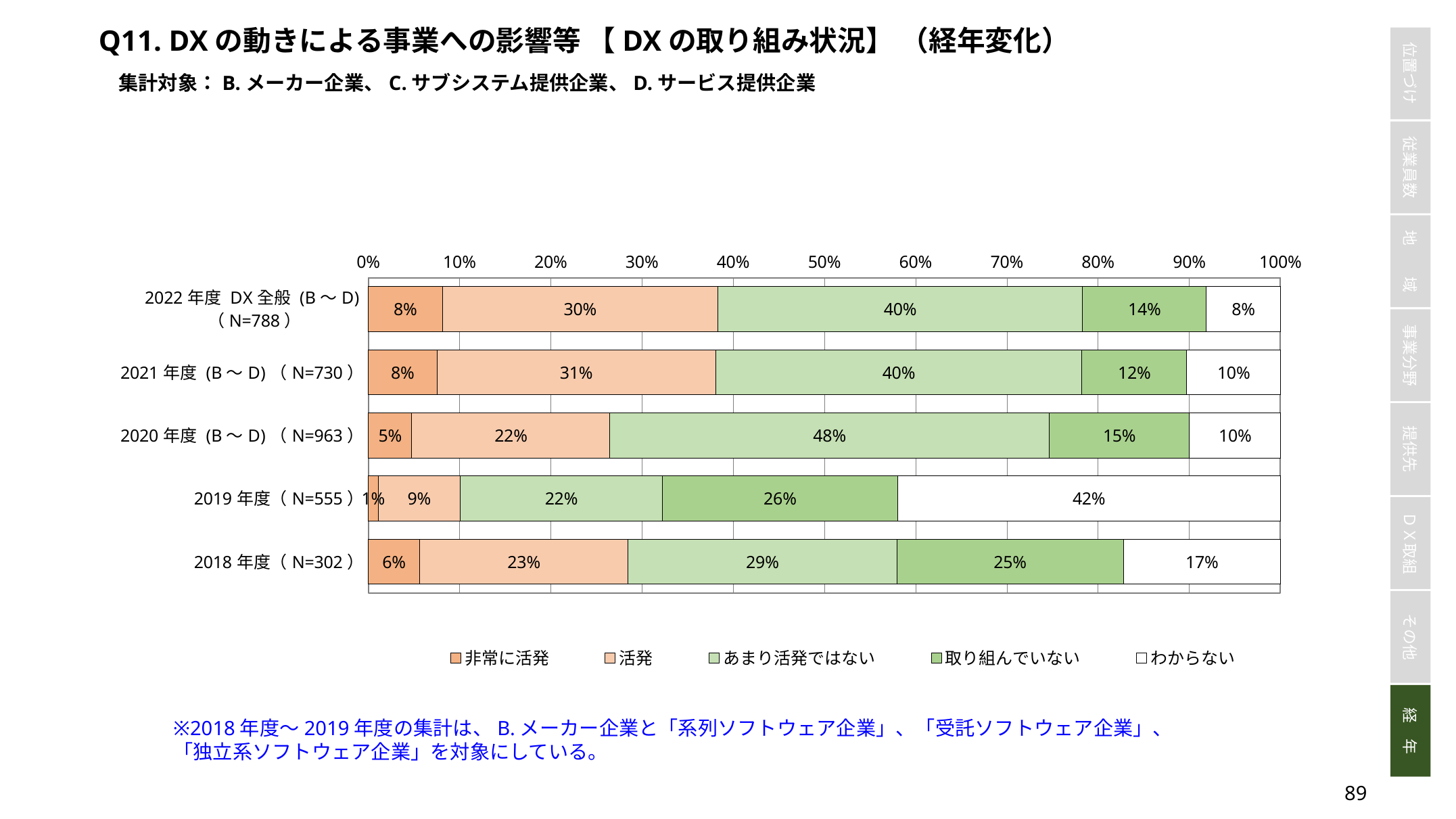
What is the value of 「あまり活発ではない」 for 2020年度 (B～D) (N=963)? 48% Which legend entry is shown in white? わからない What is the value of 「わからない」 for 2019年度 (N=555)? 42% What is the value of 「取り組んでいない」 for 2018年度 (N=302)? 25% What type of chart is shown on the slide? Stacked bar chart Which is larger: 「活発」 for 2021年度 or 「活発」 for 2020年度? 2021年度 How many year categories are plotted on the chart? 5 How many series does the legend list? 5 What is the value of 「活発」 for 2022年度 DX全般 (B～D) (N=788)? 30% What is the difference between the 「あまり活発ではない」 values for 2020年度 and 2019年度? 26% Which year has the highest value for 「わからない」? 2019年度 (N=555) Which year has the lowest value for 「非常に活発」? 2019年度 (N=555)